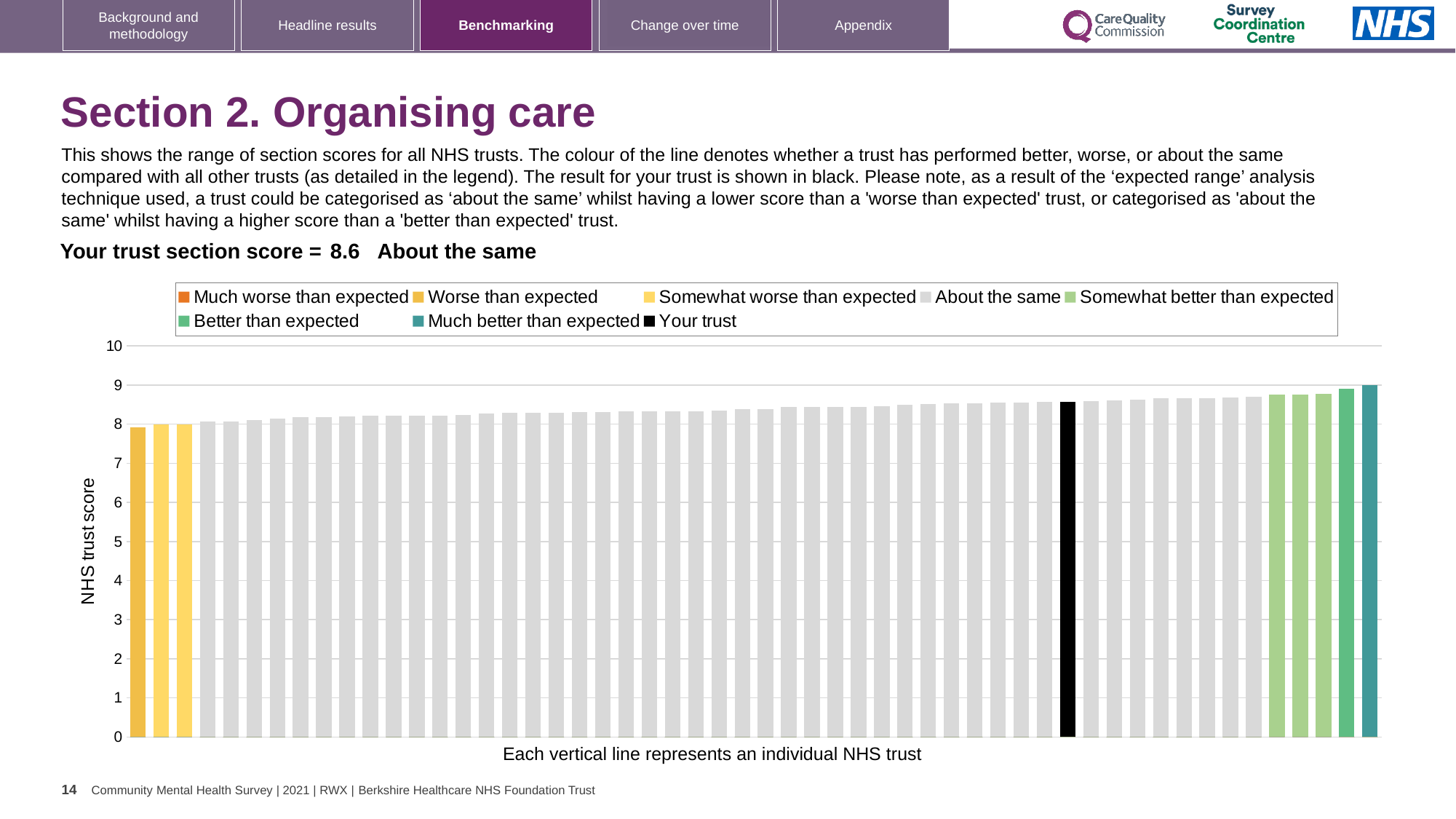
Is the value of the tallest bar greater or less than 8? greater What is the label on the vertical axis of the chart? NHS trust score What is the section score for your trust shown on the slide? 8.6 Is the value of the black bar for your trust greater or less than 8? greater Which is taller, the leftmost bar or the rightmost bar? the rightmost bar What kind of chart is shown on the slide? bar chart How many entries does the chart legend list? 8 Is the value of the leftmost bar greater or less than 7? greater What colour is the bar representing your trust? black Do the bar values rise or fall moving from left to right along the x axis? rise Which performance category is your trust placed in for this section? About the same